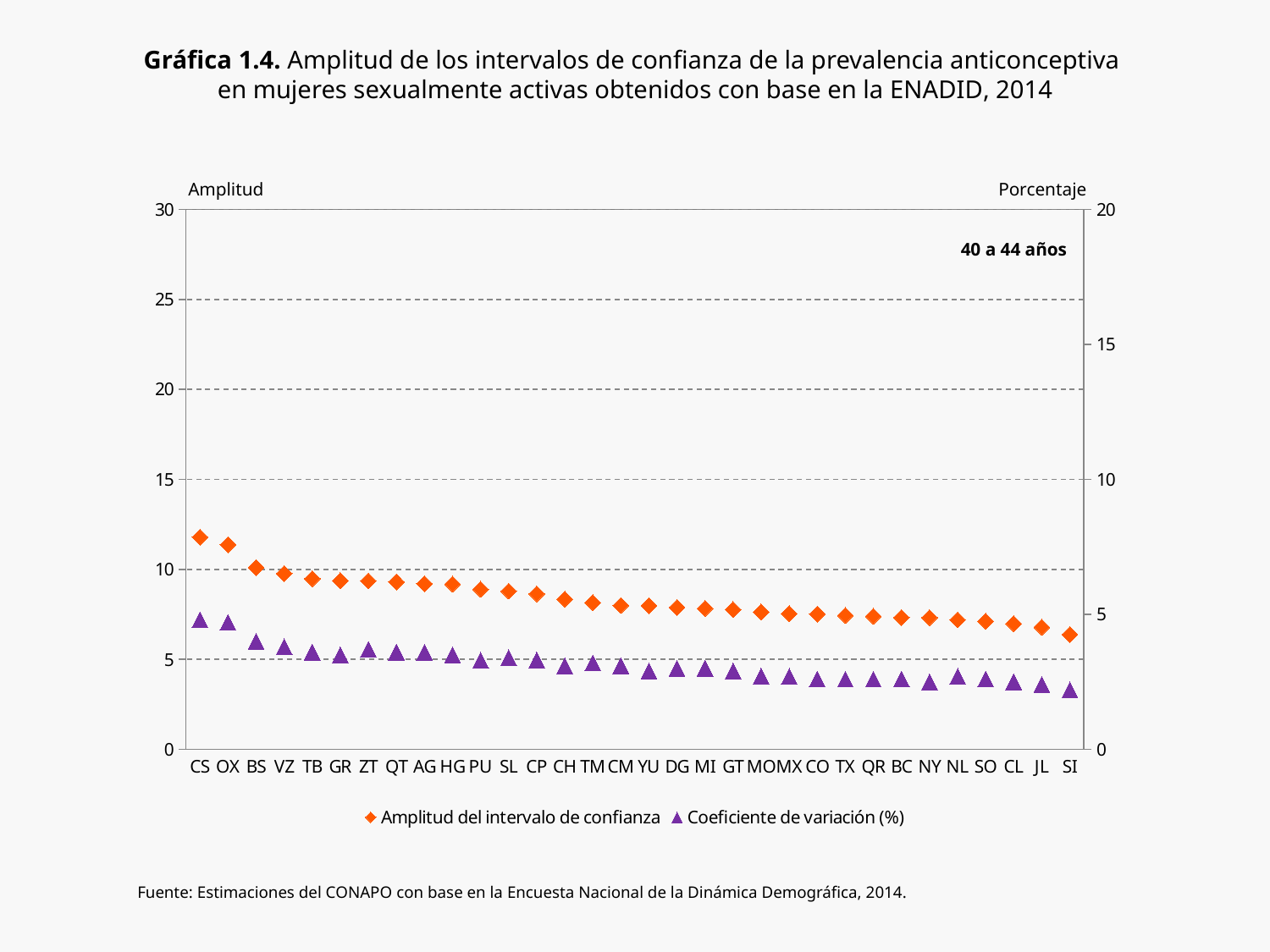
Which age group is indicated in the label inside the plot area? 40 a 44 años Is the Amplitud del intervalo de confianza for CS greater or less than 10? greater What kind of chart is shown on the slide? scatter chart How many series does the legend list? 2 Which category has the highest value for Amplitud del intervalo de confianza? CS Which has a larger Amplitud del intervalo de confianza, CS or SI? CS Is the Coeficiente de variación (%) for SI greater or less than 5 on the right axis? less Is the Amplitud del intervalo de confianza for OX greater or less than 10? greater Which category has the lowest value for Amplitud del intervalo de confianza? SI Do the values for Amplitud del intervalo de confianza rise or fall from left to right along the x axis? fall How many categories (state abbreviations) are shown on the x axis? 32